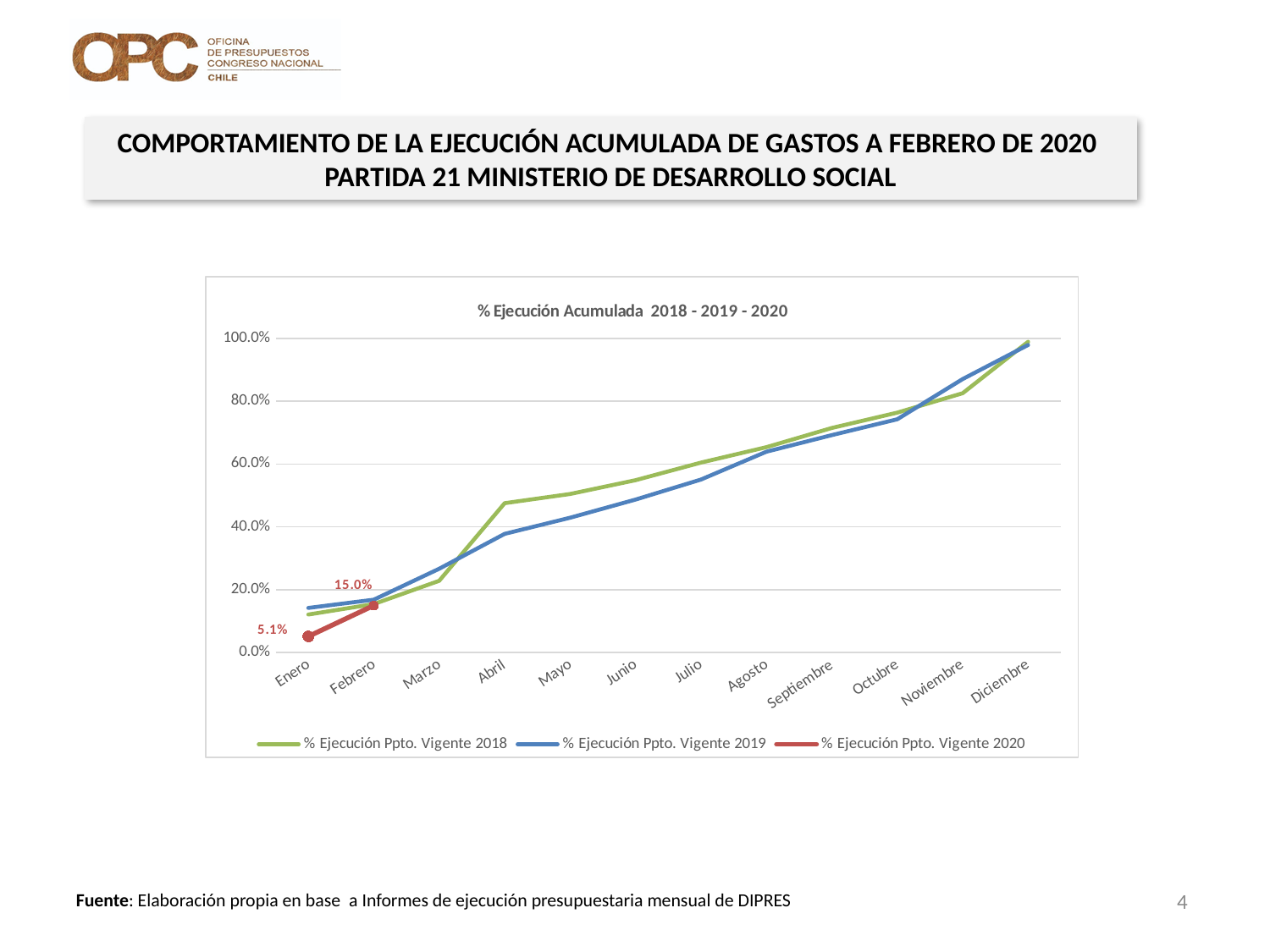
In Abril, which series has the larger value: % Ejecución Ppto. Vigente 2018 or % Ejecución Ppto. Vigente 2019? % Ejecución Ppto. Vigente 2018 How many months are shown on the x axis? 12 What is the title of the chart? % Ejecución Acumulada 2018 - 2019 - 2020 By how many percentage points did % Ejecución Ppto. Vigente 2020 increase from Enero to Febrero? 9.9 percentage points What is the value of % Ejecución Ppto. Vigente 2020 for Febrero? 15.0% What kind of chart is shown on the slide? Line chart How many series does the legend list? 3 Does the % Ejecución Ppto. Vigente 2019 line rise or fall from Enero to Diciembre? Rises In which month does % Ejecución Ppto. Vigente 2019 reach its highest value? Diciembre Is the value for % Ejecución Ppto. Vigente 2018 in Abril greater or less than 40%? greater What is the value of % Ejecución Ppto. Vigente 2020 for Enero? 5.1% Is the value for % Ejecución Ppto. Vigente 2019 in Julio greater or less than 60%? less